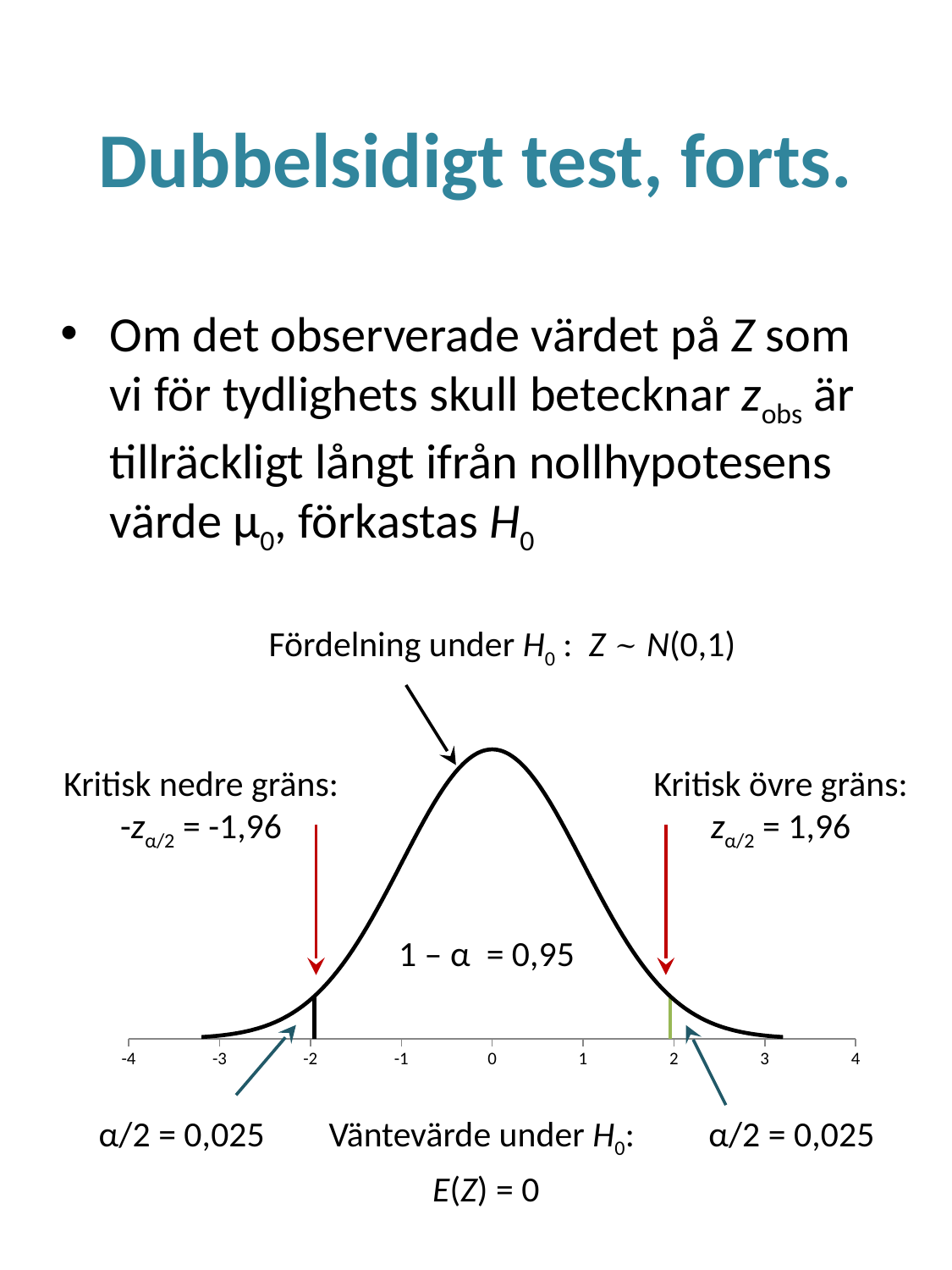
What is the expected value E(Z) under H0 according to the chart? 0 At which x value does the curve reach its peak? 0 Does the curve rise or fall as x goes from 0 to 3? fall What is the value of the critical lower bound (Kritisk nedre gräns) shown on the chart? -1,96 What kind of chart is shown on the slide? line chart Which distribution is the curve labelled as following under H0? N(0,1) What is the highest tick value on the x axis? 4 What is the lowest tick value on the x axis? -4 What is the value of the critical upper bound (Kritisk övre gräns) shown on the chart? 1,96 What value is given for α/2 in each tail of the distribution? 0,025 How many tick labels are shown on the x axis? 9 What value is given for 1 – α in the middle of the curve? 0,95